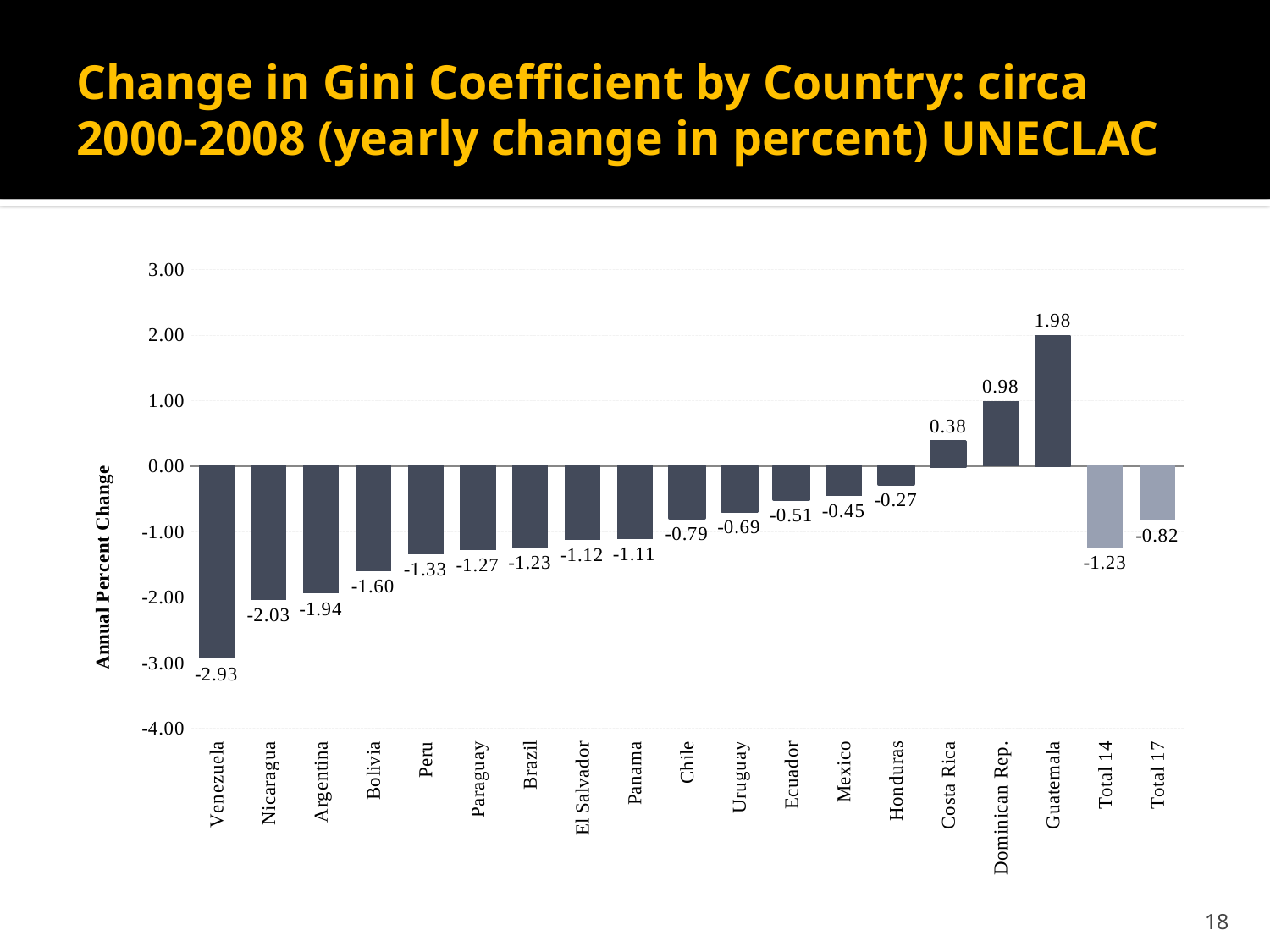
What kind of chart is shown on the slide? Bar chart What is the value for Venezuela? -2.93 Which country has the lowest value? Venezuela Which country has the highest value? Guatemala Which has a larger value, Costa Rica or Dominican Rep.? Dominican Rep. What is the difference between the values for Guatemala and Dominican Rep.? 1.00 What is the label on the vertical axis? Annual Percent Change What is the difference between the values for Venezuela and Nicaragua? 0.90 What is the value for Guatemala? 1.98 What is the value for Honduras? -0.27 What is the value for Total 17? -0.82 How many bars are plotted in the chart? 19